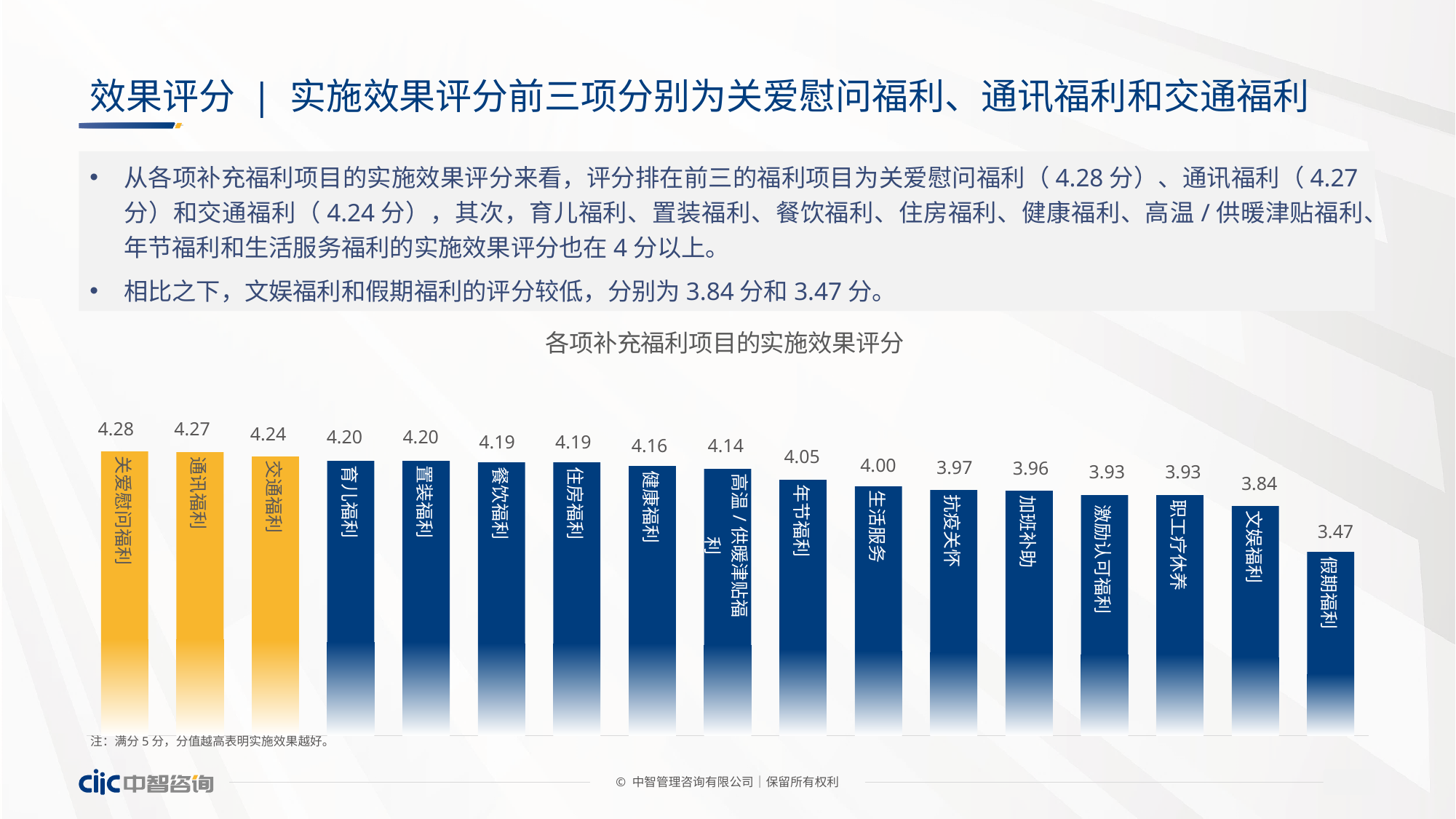
从左到右，各柱子的评分呈上升还是下降趋势？ 下降 关爱慰问福利与假期福利的评分相差多少？ 0.81 文娱福利与假期福利的评分相差多少？ 0.37 图表“各项补充福利项目的实施效果评分”中，关爱慰问福利的评分是多少？ 4.28 图表中有几根柱子是黄色（橙色）的？ 3 图表中，健康福利的实施效果评分是多少？ 4.16 图表中，加班补助的评分是多少？ 3.96 图表中共有多少个福利项目（柱子）？ 17 图表中哪个福利项目的实施效果评分最低？ 假期福利 这是什么类型的图表？ 柱状图（条形图） 交通福利和年节福利，哪个评分更高？ 交通福利 图表中哪个福利项目的实施效果评分最高？ 关爱慰问福利